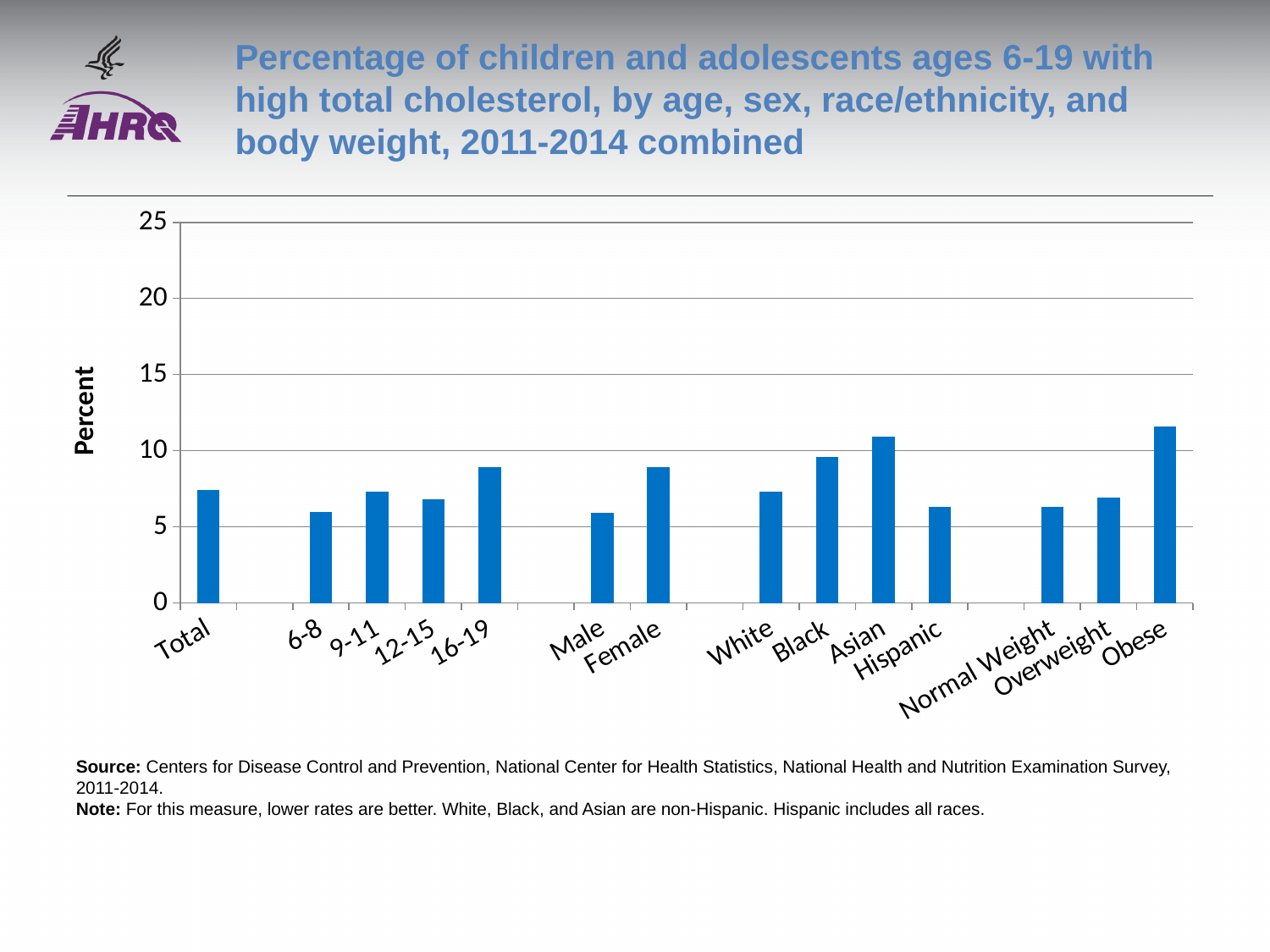
What is the label on the vertical axis of the chart? Percent Which category has the highest percentage of children and adolescents with high total cholesterol? Obese Is the value for Obese greater or less than 10? greater How many categories are plotted along the x axis? 14 Which is larger, the value for Black or the value for White? Black Is the value for Male greater or less than 10? less Is the value for Total greater or less than 5? greater What kind of chart is shown on the slide? bar chart Which is larger, the value for Female or the value for Male? Female Which is larger, the value for 16-19 or the value for 6-8? 16-19